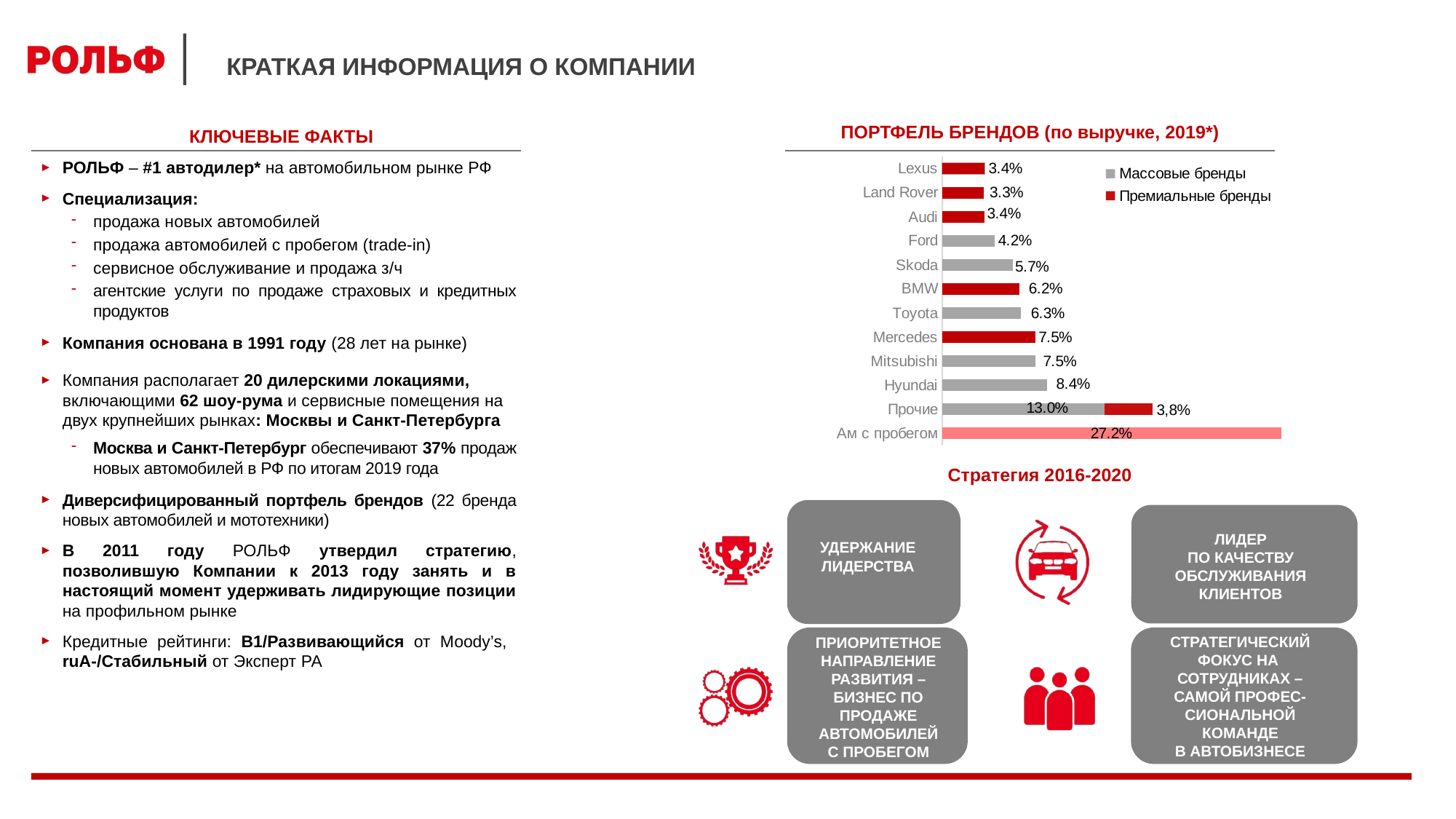
Which is larger in the brand portfolio chart, the value for Hyundai or the value for Skoda? Hyundai How many series does the legend of the brand portfolio chart list? 2 How many categories are shown in the brand portfolio chart? 12 What is the value for Skoda in the brand portfolio chart? 5.7% What is the value for BMW in the brand portfolio chart? 6.2% What is the value for Hyundai in the brand portfolio chart? 8.4% What is the value for Ам с пробегом in the brand portfolio chart? 27.2% What colour represents Премиальные бренды in the brand portfolio chart? Red What is the difference between the values for Hyundai and Ford in the brand portfolio chart? 4.2% What kind of chart is the brand portfolio chart? Bar chart Which category has the highest value in the brand portfolio chart? Ам с пробегом What is the total of the stacked bar for Прочие in the brand portfolio chart? 16.8%